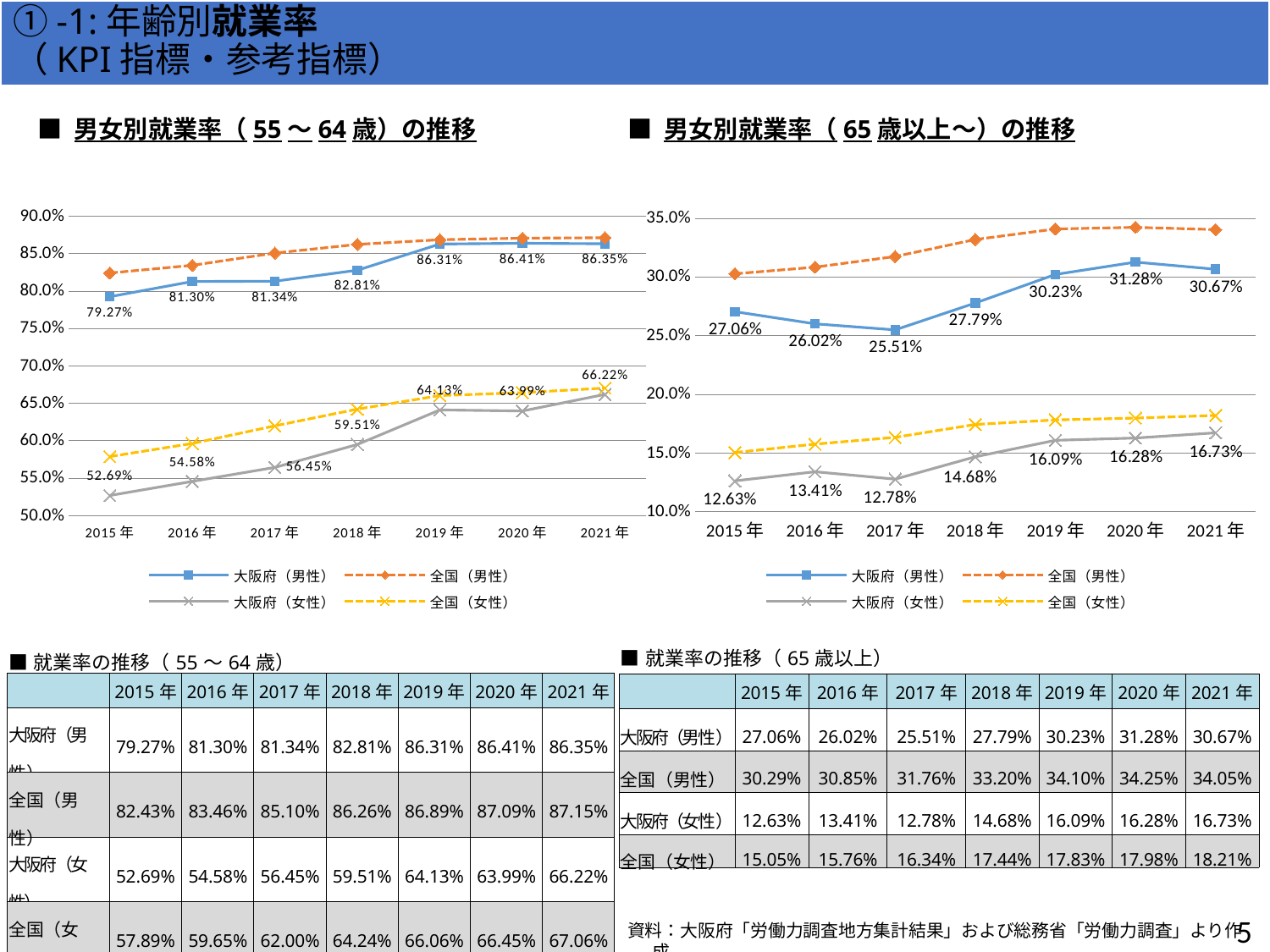
In the left chart (男女別就業率（55～64歳）の推移), is the value for 全国（男性） in 2021年 greater or less than 85.0%? greater In the right chart (男女別就業率（65歳以上～）の推移), in which year is 大阪府（男性） highest? 2020年 What kind of chart is the left chart (男女別就業率（55～64歳）の推移)? Line chart In the left chart (男女別就業率（55～64歳）の推移), what is the difference between 大阪府（男性） and 大阪府（女性） in 2021年? 20.13% In the left chart (男女別就業率（55～64歳）の推移), does 大阪府（女性） generally rise or fall from 2015年 to 2021年? Rise In the right chart (男女別就業率（65歳以上～）の推移), what is the value for 大阪府（女性） in 2021年? 16.73% In the right chart (男女別就業率（65歳以上～）の推移), which is larger in 2019年: 大阪府（男性） or 大阪府（女性）? 大阪府（男性） How many years are plotted on the x axis of the left chart (男女別就業率（55～64歳）の推移)? 7 In the left chart (男女別就業率（55～64歳）の推移), what is the value for 大阪府（女性） in 2019年? 64.13% In the right chart (男女別就業率（65歳以上～）の推移), in which year is 大阪府（男性） lowest? 2017年 In the left chart (男女別就業率（55～64歳）の推移), what is the value for 大阪府（男性） in 2015年? 79.27% How many series does the legend of the right chart (男女別就業率（65歳以上～）の推移) list? 4